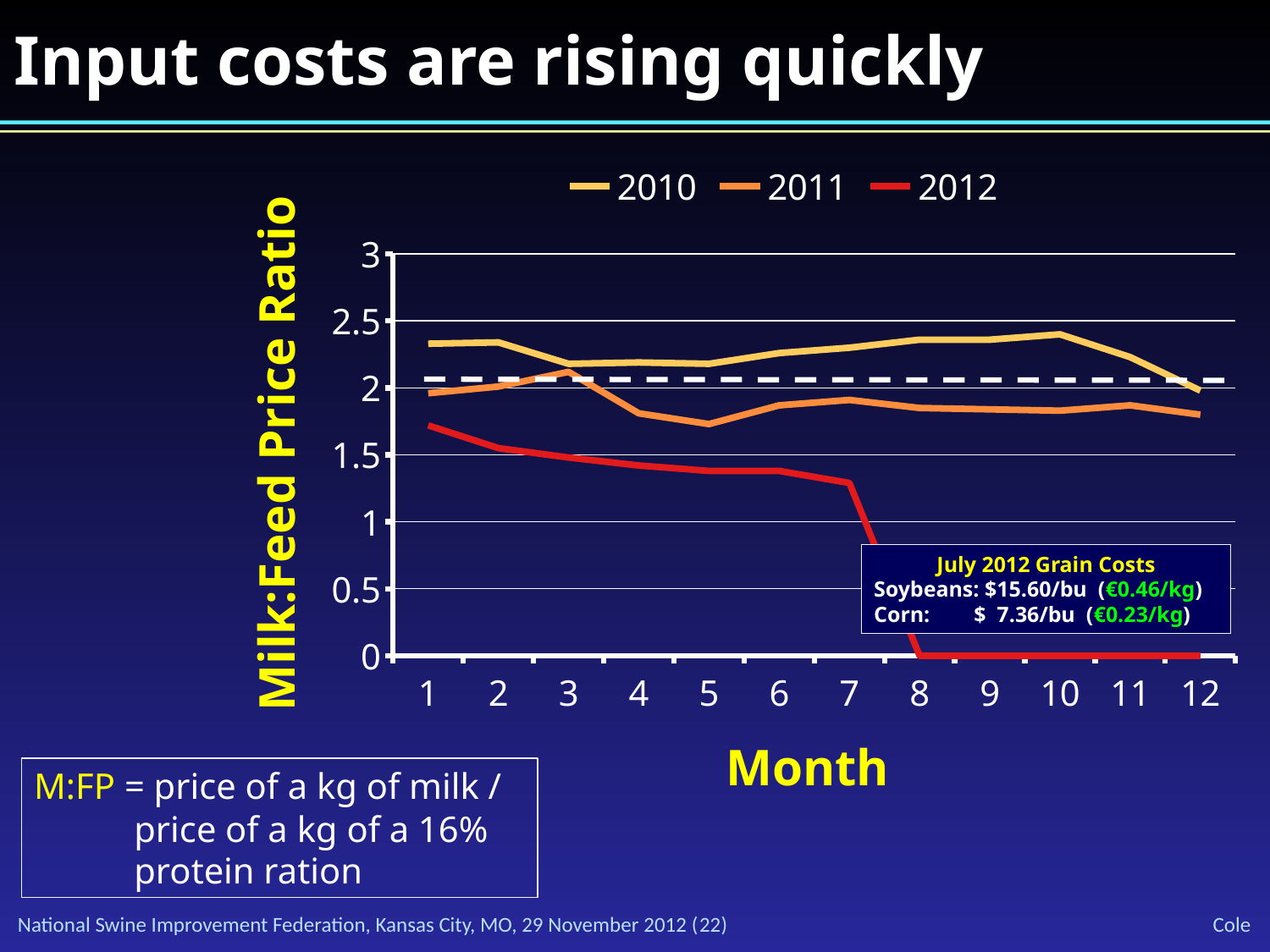
What kind of chart is shown on the slide? line chart At month 1, which series has the larger value, 2010 or 2012? 2010 Is the 2010 value for month 10 greater or less than 2.5? less Is the 2012 value for month 1 greater or less than 2? less Is the 2010 value for month 1 greater or less than 2? greater In which month does the 2012 series reach its highest value? 1 How many months are shown along the x axis? 12 How many series does the legend list? 3 What is the title of the y axis? Milk:Feed Price Ratio Does the 2012 series rise or fall from month 1 to month 7? fall